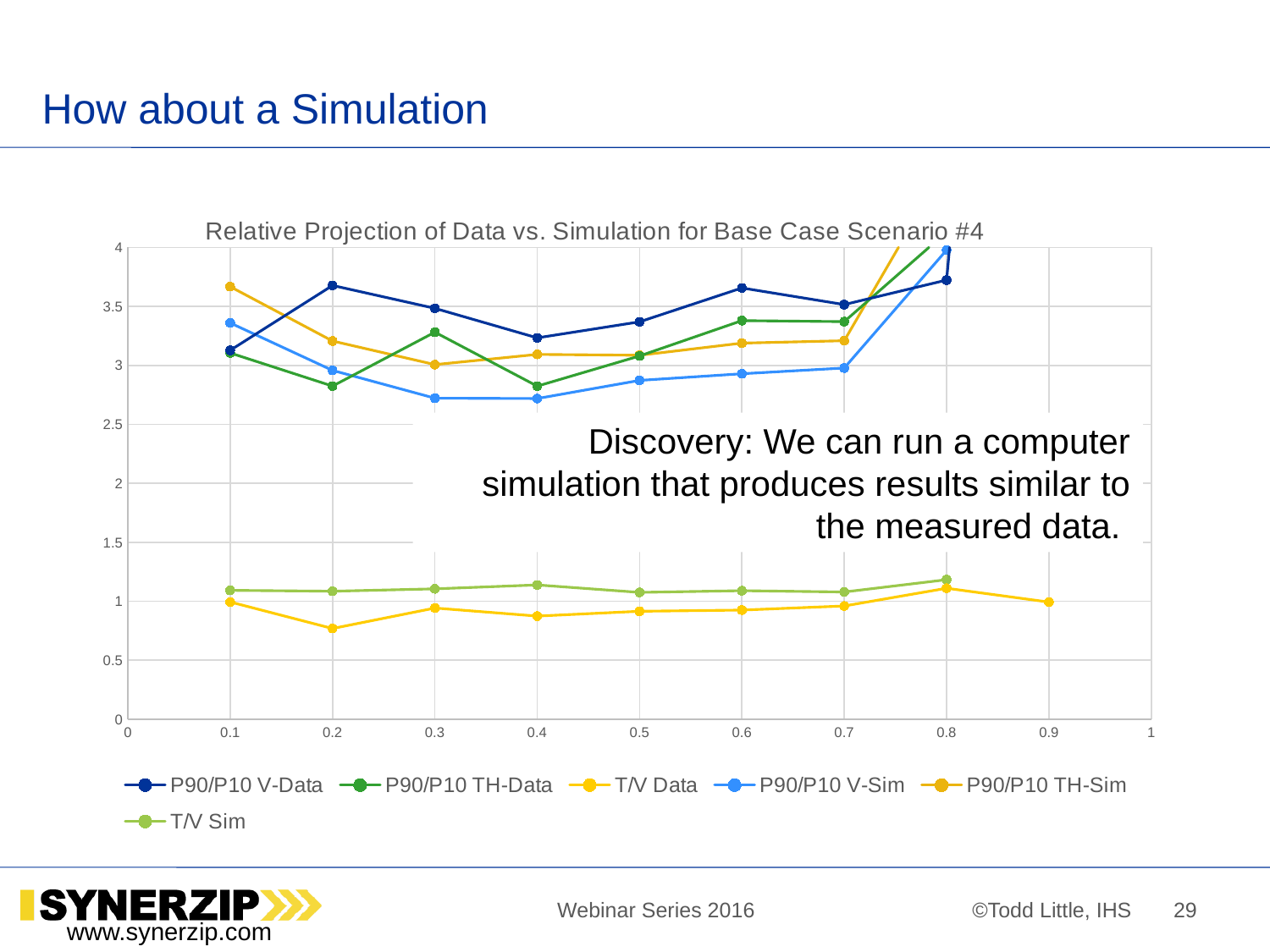
What kind of chart is shown on the slide? line chart Is the value for P90/P10 V-Sim at x = 0.4 greater or less than 3? less What is the title of the chart? Relative Projection of Data vs. Simulation for Base Case Scenario #4 At x = 0.2, which is larger: T/V Sim or T/V Data? T/V Sim Which series has the highest value at x = 0.2? P90/P10 V-Data Is the value for T/V Data at x = 0.2 greater or less than 1? less At x = 0.1, which is larger: P90/P10 TH-Sim or P90/P10 V-Data? P90/P10 TH-Sim Is the value for P90/P10 TH-Sim at x = 0.1 greater or less than 3.5? greater Which series has the lowest value at x = 0.2? T/V Data How many series does the legend list? 6